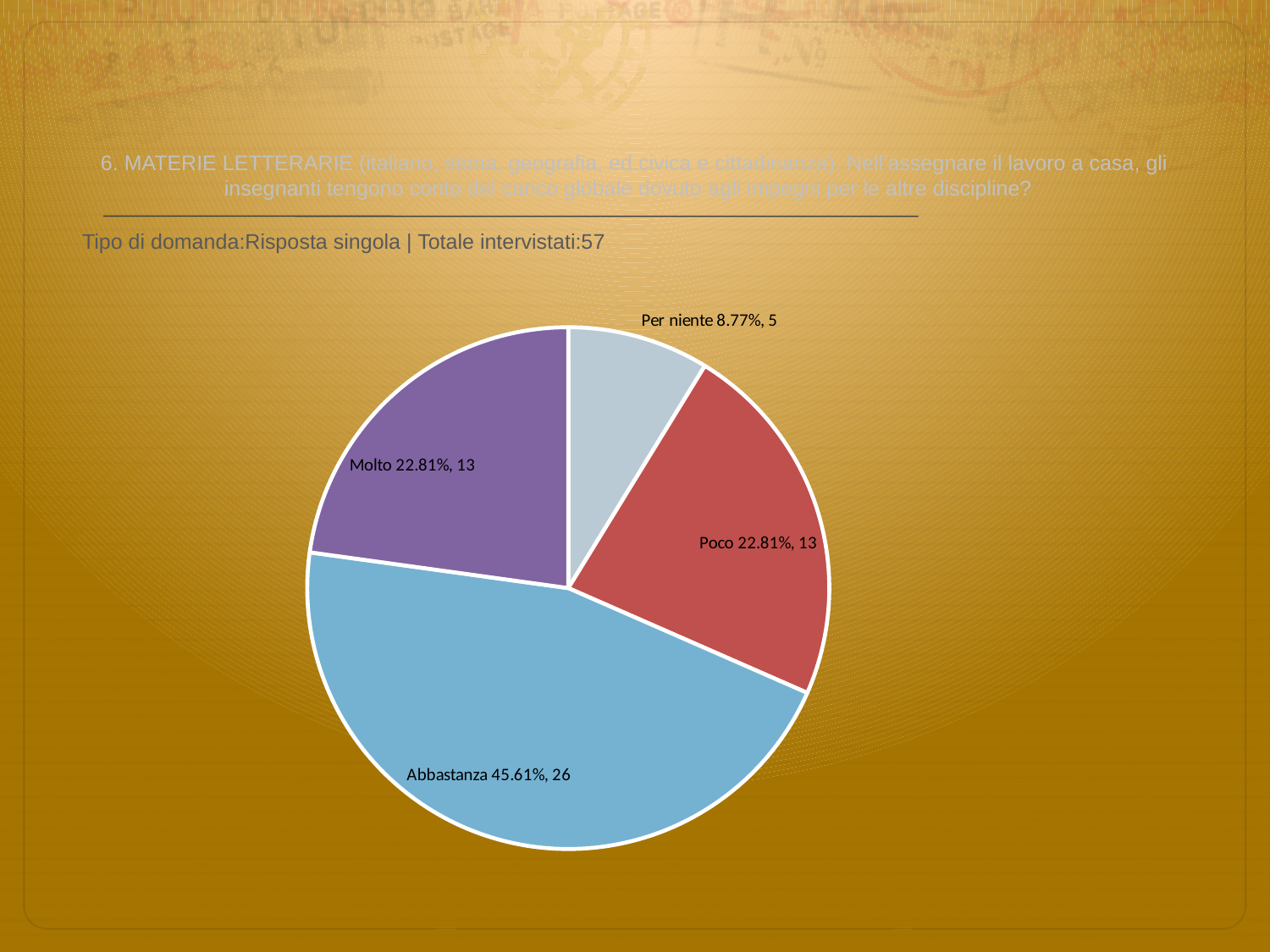
What colour is the Abbastanza slice? light blue What is the difference in respondent count between Abbastanza and Molto? 13 What kind of chart is shown on the slide? pie chart How many respondents answered Per niente? 5 How many respondents answered Molto? 13 Which category has the largest slice of the pie? Abbastanza What percentage share does the Poco slice have? 22.81% Which has more respondents, Poco or Per niente? Poco What is the total number of respondents shown across all slices? 57 What percentage share does the Abbastanza slice have? 45.61% How many slices does the pie chart have? 4 Which category has the smallest slice of the pie? Per niente